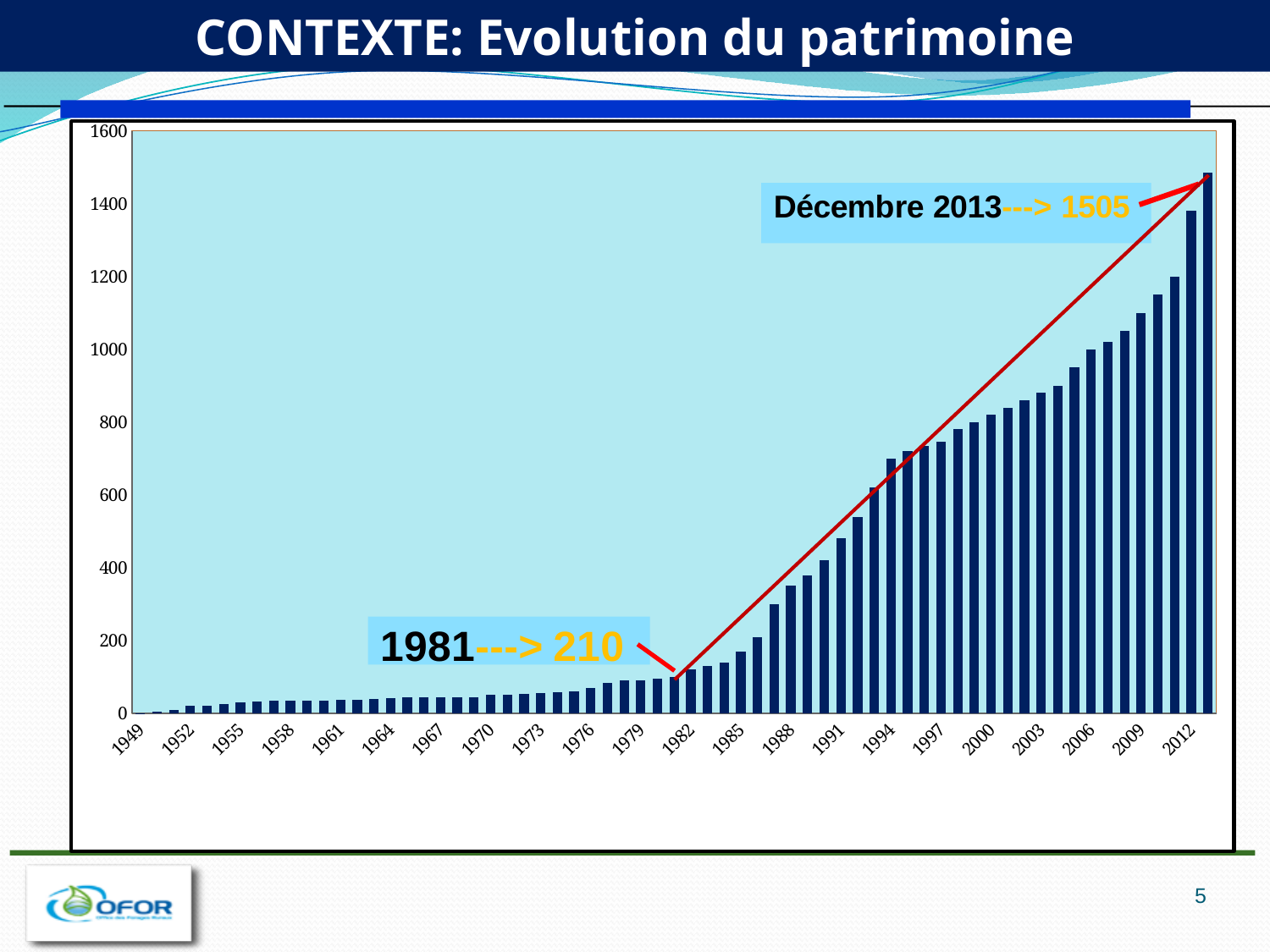
Which year has the larger value, 1988 or 1994? 1994 Is the value for 1970 greater or less than 200? less Is the value for 1994 greater or less than 600? greater Do the bar values generally rise or fall from 1949 to 2013? rise Is the value for 1985 greater or less than 200? less What kind of chart is shown on the slide? bar chart Which year has the lowest bar on the chart? 1949 What is the title of the slide containing the chart? CONTEXTE: Evolution du patrimoine According to the annotation on the chart, what value is given for 1981? 210 According to the annotation on the chart, what value is given for Décembre 2013? 1505 Which year has the highest bar on the chart? 2013